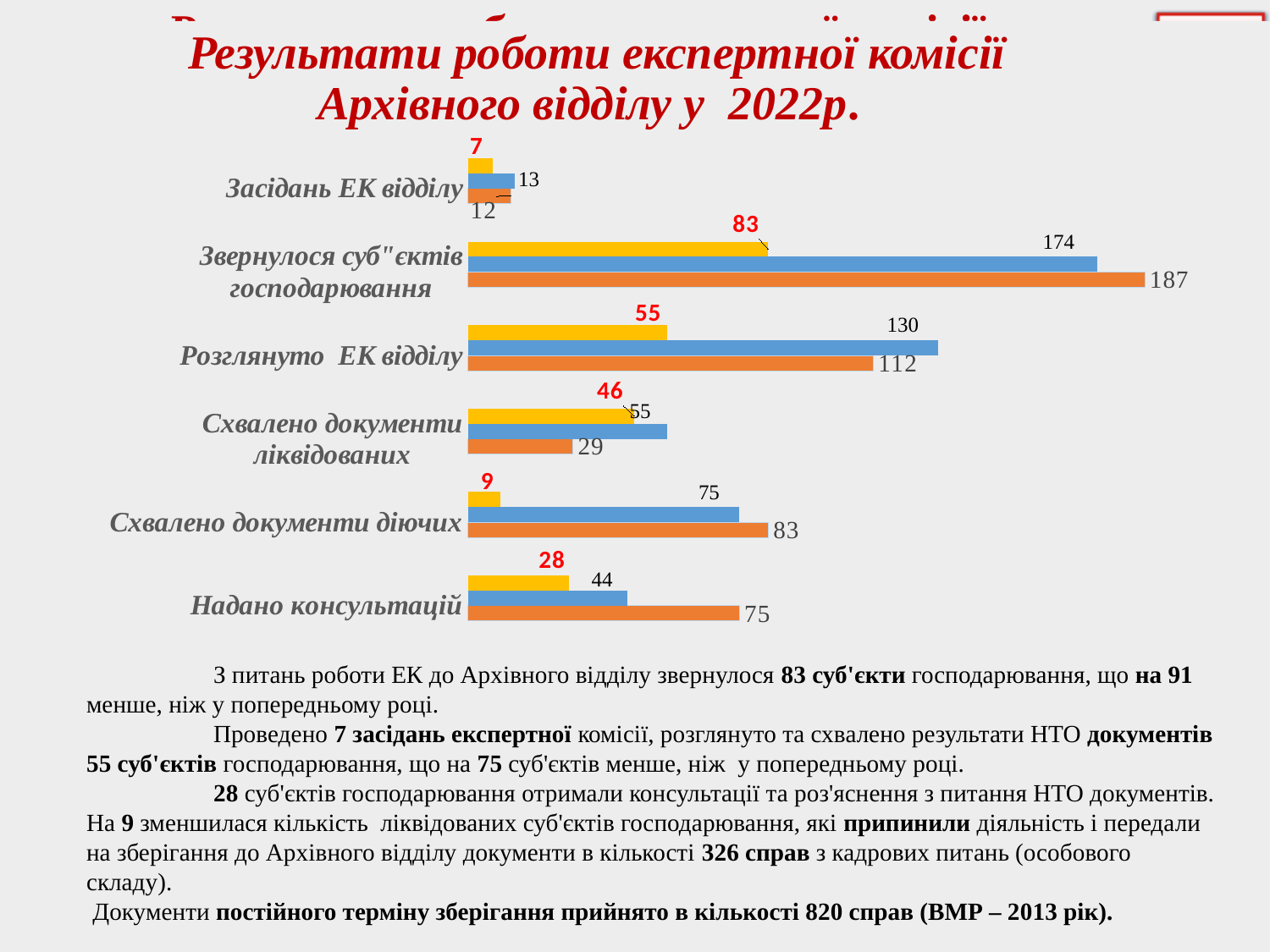
What is the difference between the orange bar (187) and the yellow bar (83) for "Звернулося суб"єктів господарювання"? 104 What is the title of the chart? Результати роботи експертної комісії Архівного відділу у 2022р. Which category has the lowest value among the yellow bars? Засідань ЕК відділу What kind of chart is shown on the slide? bar chart What is the value of the orange bar for "Надано консультацій"? 75 What is the value of the yellow bar for "Засідань ЕК відділу"? 7 Which category has the highest value among the yellow bars? Звернулося суб"єктів господарювання What is the value of the blue bar for "Розглянуто ЕК відділу"? 130 For "Схвалено документи діючих", which is larger: the yellow bar or the blue bar? the blue bar How many categories are shown on the chart? 6 For "Схвалено документи ліквідованих", which is larger: the blue bar or the orange bar? the blue bar What is the value of the yellow bar for "Звернулося суб"єктів господарювання"? 83